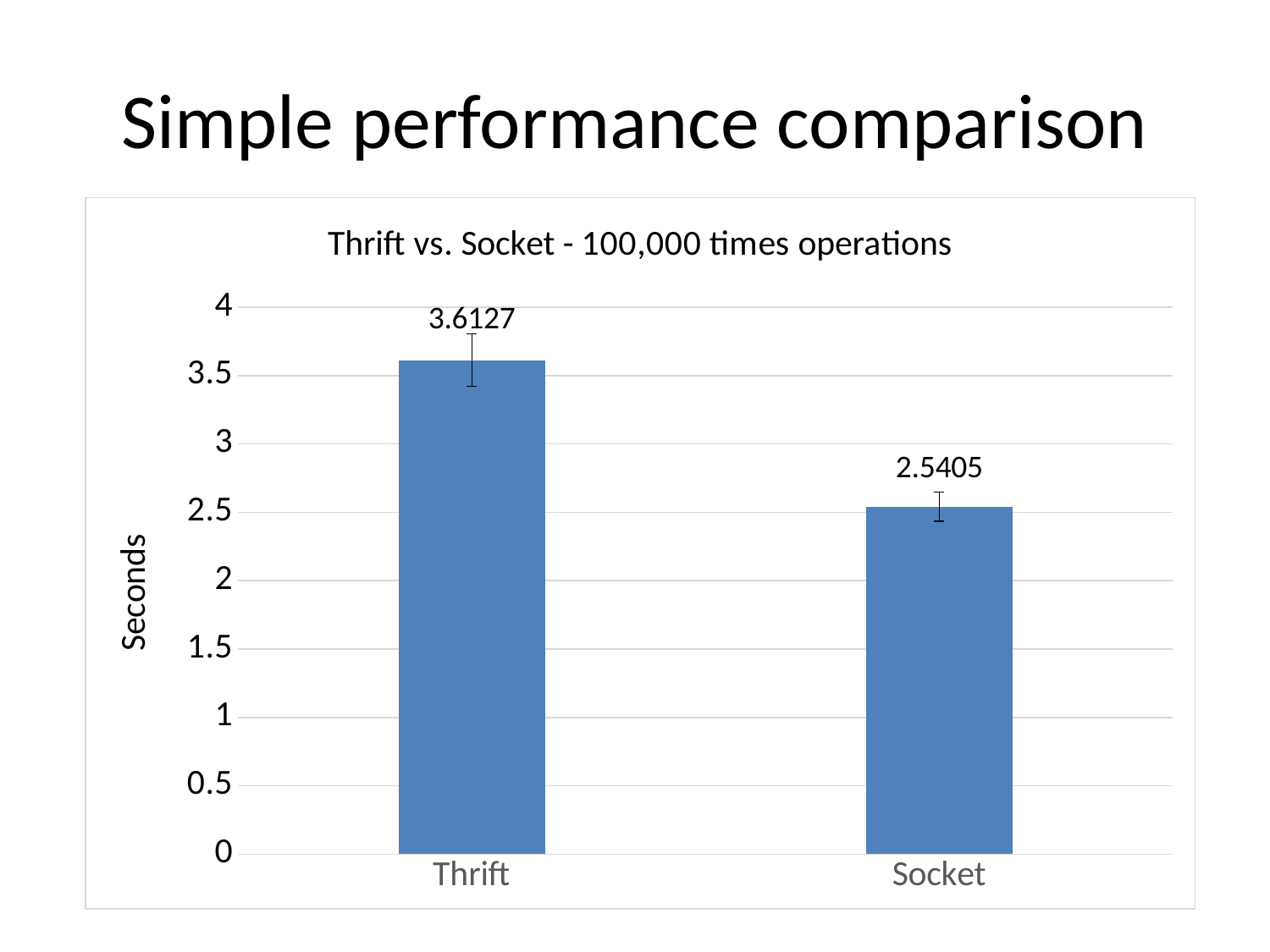
What is the difference between the values for Thrift and Socket? 1.0722 What is the label of the vertical axis? Seconds What is the value for Thrift? 3.6127 Is the value for Socket greater or less than 3? less What kind of chart is shown? bar chart Which is larger, the value for Thrift or the value for Socket? Thrift How many categories are shown on the x axis? 2 Which category has the highest value? Thrift What is the value for Socket? 2.5405 Is the value for Thrift greater or less than 3? greater What is the title of the chart? Thrift vs. Socket - 100,000 times operations Which category has the lowest value? Socket